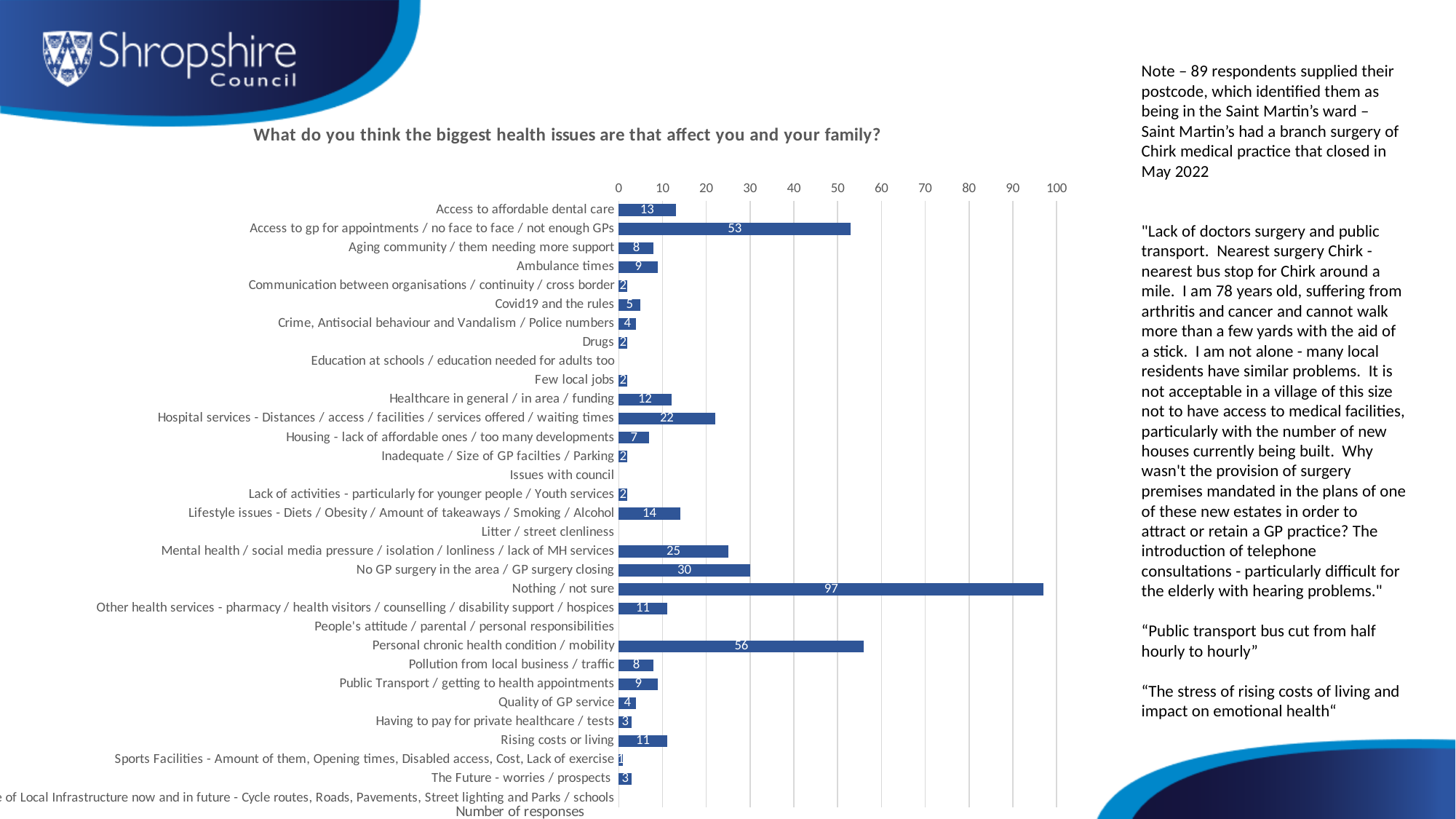
What is the number of responses for "Nothing / not sure"? 97 What is the number of responses for "Personal chronic health condition / mobility"? 56 Which category has the highest number of responses? Nothing / not sure What is the value for "Ambulance times"? 9 What kind of chart is shown on the slide? Bar chart Is the value for "Nothing / not sure" greater or less than 90? greater What is the title of the chart? What do you think the biggest health issues are that affect you and your family? How many responses are shown for "Lifestyle issues - Diets / Obesity / Amount of takeaways / Smoking / Alcohol"? 14 What is the difference between the values for "Personal chronic health condition / mobility" and "Access to affordable dental care"? 43 What is the difference in responses between "Access to gp for appointments / no face to face / not enough GPs" and "No GP surgery in the area / GP surgery closing"? 23 Which has more responses: "Mental health / social media pressure / isolation / lonliness / lack of MH services" or "Hospital services - Distances / access / facilities / services offered / waiting times"? Mental health / social media pressure / isolation / lonliness / lack of MH services What is the label on the value axis of the chart? Number of responses